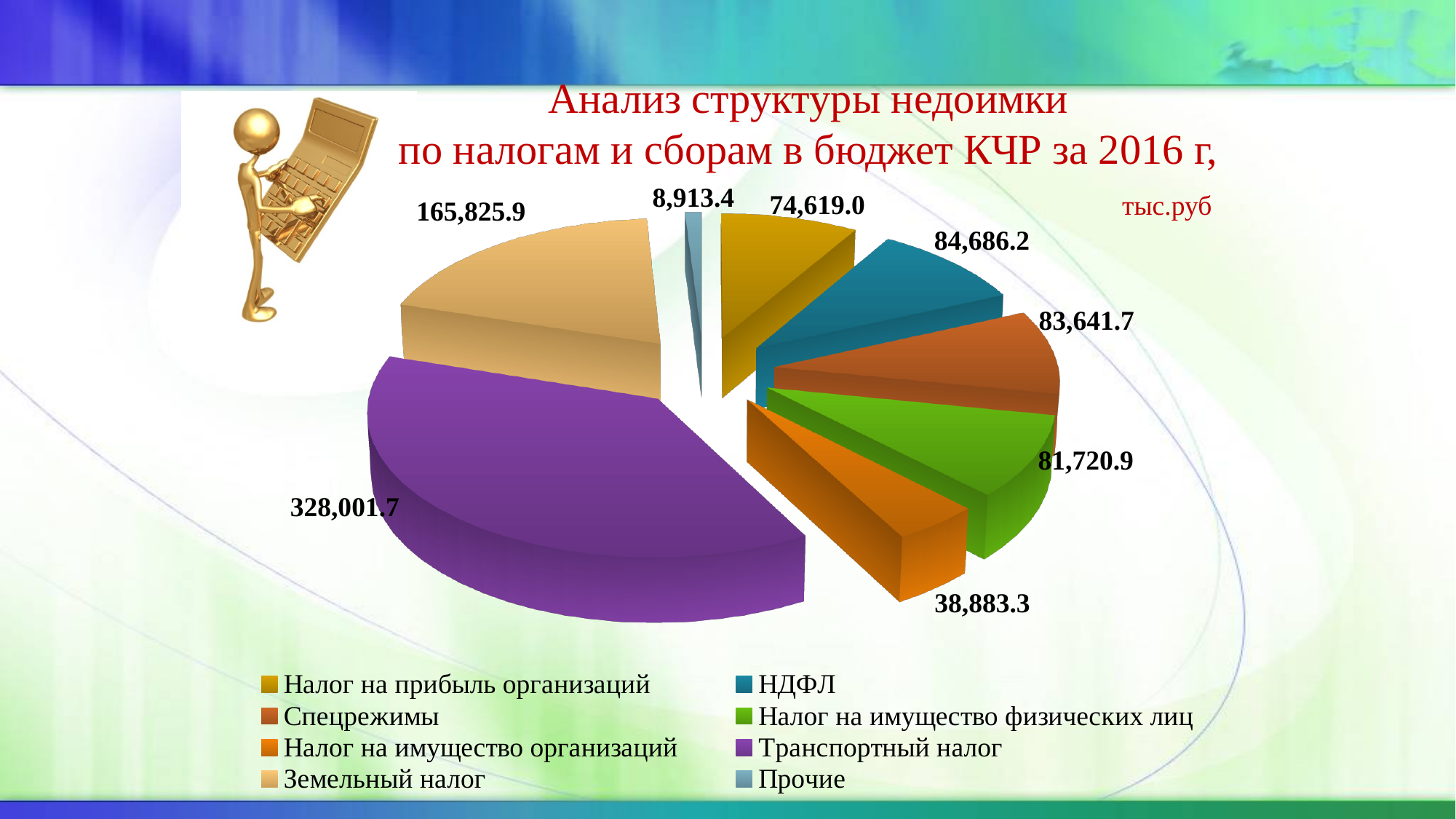
What is the value for Налог на имущество организаций? 38,883.3 Which category has the smallest slice of the pie? Прочие What is the value for Прочие? 8,913.4 What is the value for Земельный налог? 165,825.9 What is the difference between the values for Транспортный налог and Земельный налог? 162,175.8 What kind of chart is shown on the slide? pie chart Which is larger, Земельный налог or Налог на прибыль организаций? Земельный налог What is the value for Транспортный налог? 328,001.7 How many categories does the pie chart have? 8 Which category has the largest slice of the pie? Транспортный налог What unit is stated for the values in the chart? тыс.руб What is the value for НДФЛ? 84,686.2